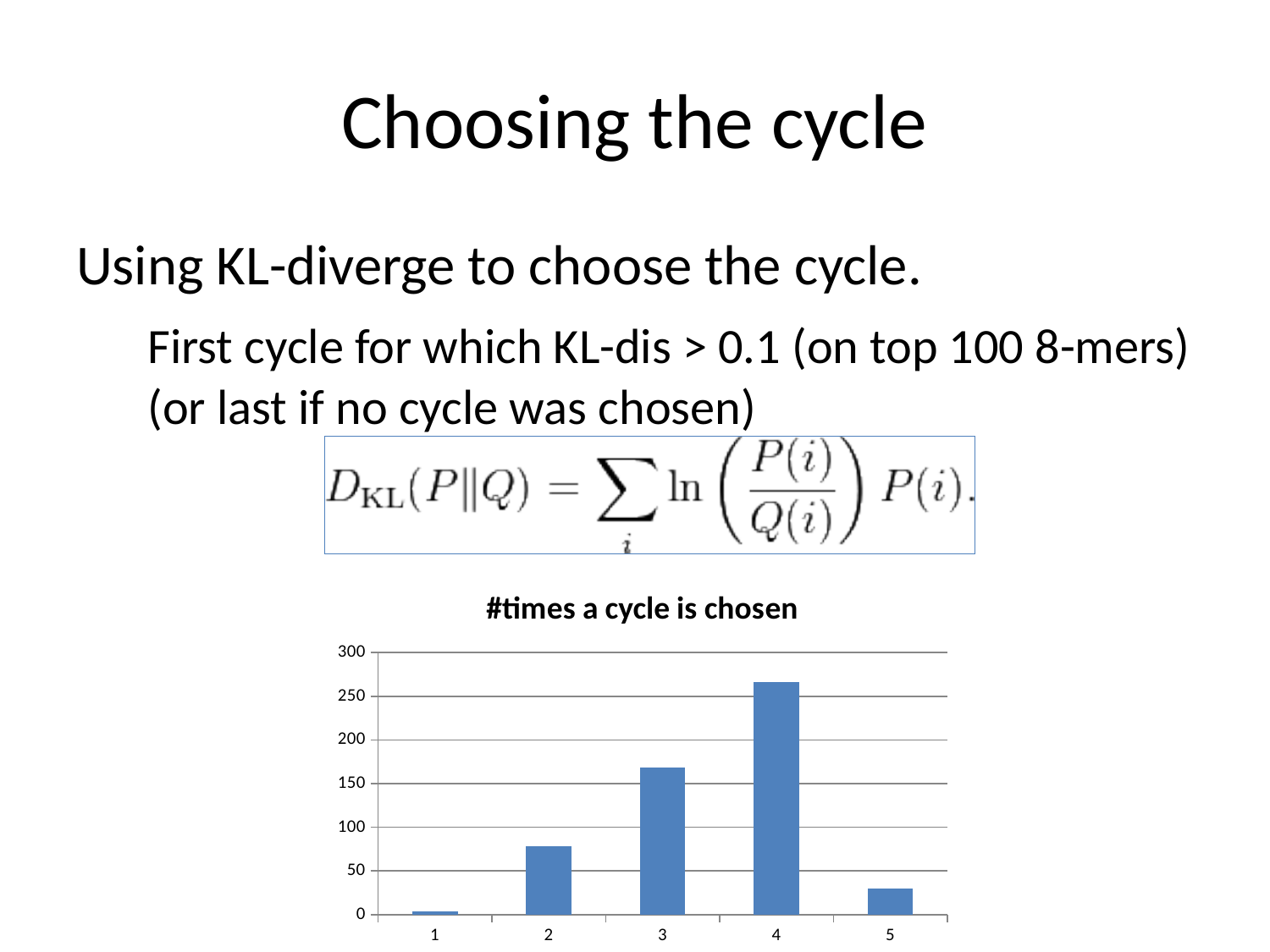
How many categories are shown on the x axis of the chart? 5 Which cycle has the highest number of times chosen? 4 What is the highest value shown on the y axis of the chart? 300 What is the title of the chart on the slide? #times a cycle is chosen Is the value for cycle 2 greater or less than 100? less Which cycle has the lowest number of times chosen? 1 What kind of chart is shown on the slide? bar chart Which is larger, the value for cycle 3 or the value for cycle 4? cycle 4 Which is larger, the value for cycle 2 or the value for cycle 5? cycle 2 Is the value for cycle 5 greater or less than 50? less Is the value for cycle 4 greater or less than 250? greater